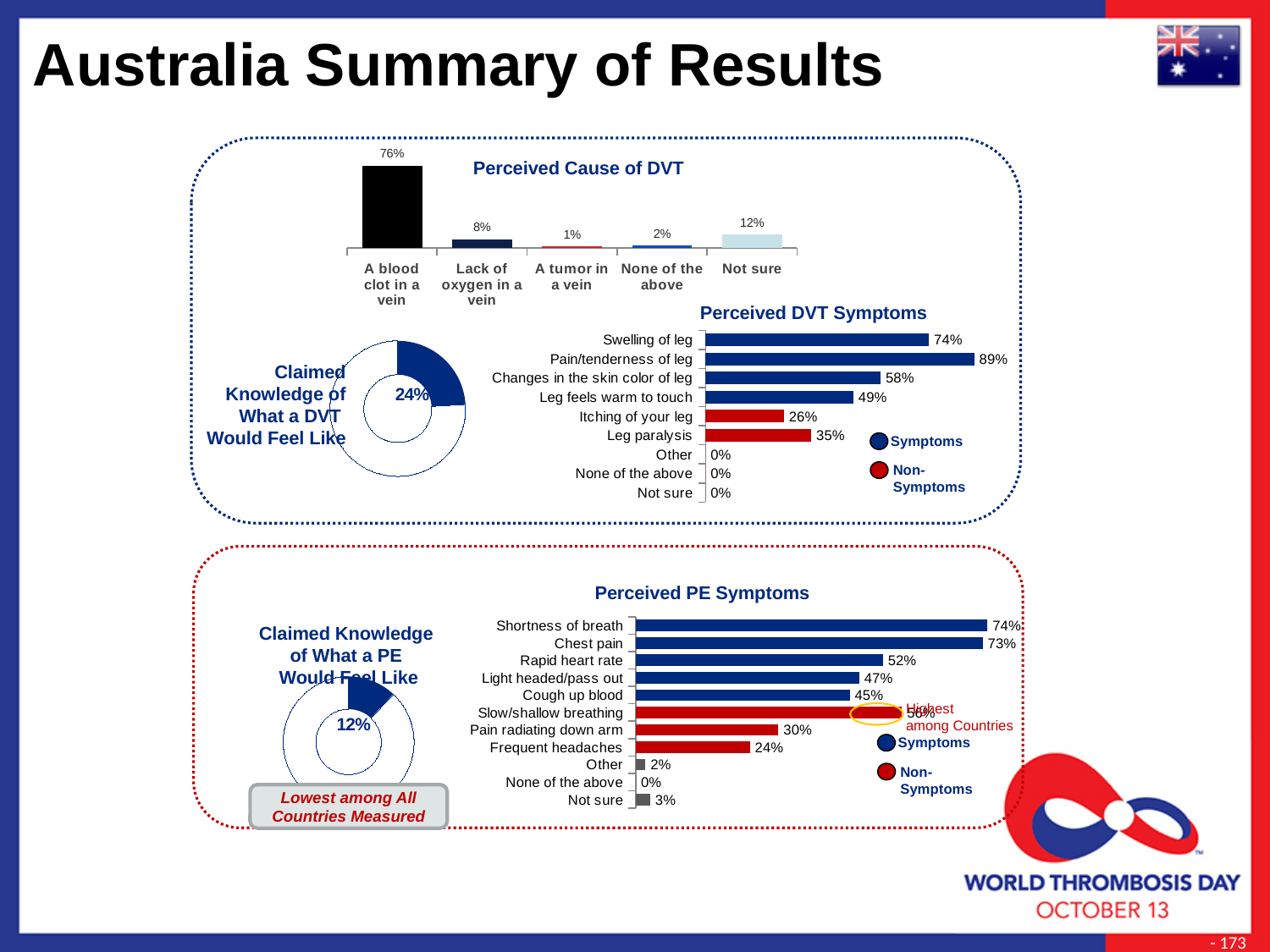
What type of chart is the Perceived PE Symptoms chart? Bar chart In the Perceived DVT Symptoms chart, how many series does the legend list? 2 What value is shown in the 'Claimed Knowledge of What a DVT Would Feel Like' donut chart? 24% In the Perceived DVT Symptoms chart, which symptom has the highest value? Pain/tenderness of leg In the Perceived Cause of DVT chart, what percentage chose 'A blood clot in a vein'? 76% In the Perceived DVT Symptoms chart, which is larger: 'Changes in the skin color of leg' or 'Leg feels warm to touch'? Changes in the skin color of leg In the Perceived Cause of DVT chart, how many categories are shown? 5 In the Perceived DVT Symptoms chart, what is the value for 'Leg paralysis'? 35% In the Perceived PE Symptoms chart, what is the value for 'Pain radiating down arm'? 30% What value is shown in the 'Claimed Knowledge of What a PE Would Feel Like' donut chart? 12% In the Perceived Cause of DVT chart, which category has the lowest value? A tumor in a vein In the Perceived Cause of DVT chart, what is the difference between 'Not sure' and 'Lack of oxygen in a vein'? 4%